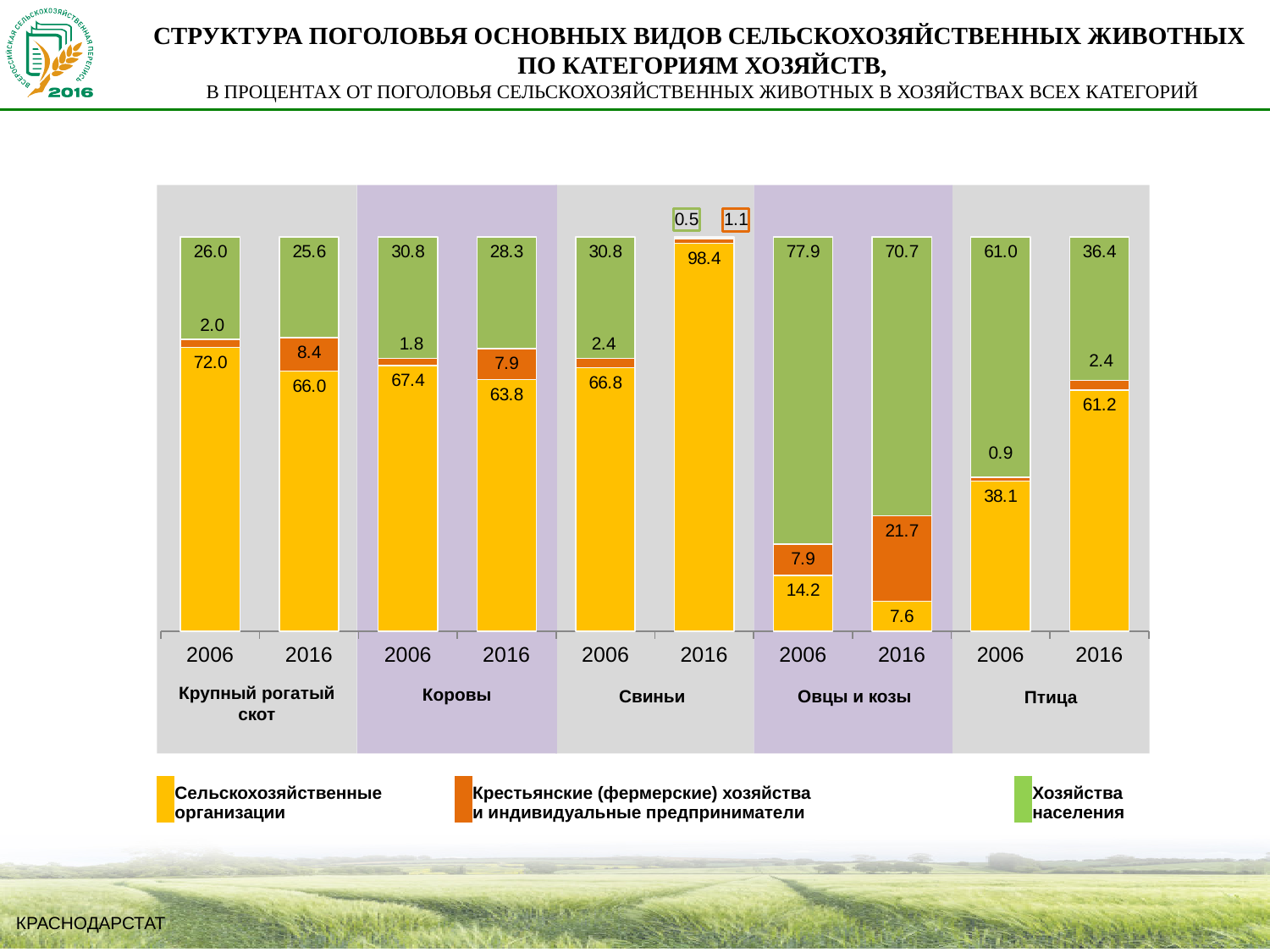
How many series does the legend list? 3 What share of sheep and goats (Овцы и козы) was held by peasant (farm) holdings and individual entrepreneurs in 2016? 21.7 Among the 2016 bars, which animal group has the highest share for agricultural organisations (Сельскохозяйственные организации)? Свиньи How many animal groups are shown along the x axis? 5 What share of cattle (Крупный рогатый скот) was held by agricultural organisations in 2006? 72.0 What share of pigs (Свиньи) was held by agricultural organisations (Сельскохозяйственные организации) in 2016? 98.4 What kind of chart is shown on the slide? Stacked bar chart What share of poultry (Птица) was held by households (Хозяйства населения) in 2006? 61.0 Among the 2006 bars, which animal group has the lowest share for agricultural organisations (Сельскохозяйственные организации)? Овцы и козы For poultry (Птица), which is larger: the households' share in 2006 or in 2016? 2006 Which colour represents households (Хозяйства населения) in the chart? Green By how much did the share of cows (Коровы) held by agricultural organisations change from 2006 (67.4) to 2016 (63.8)? 3.6